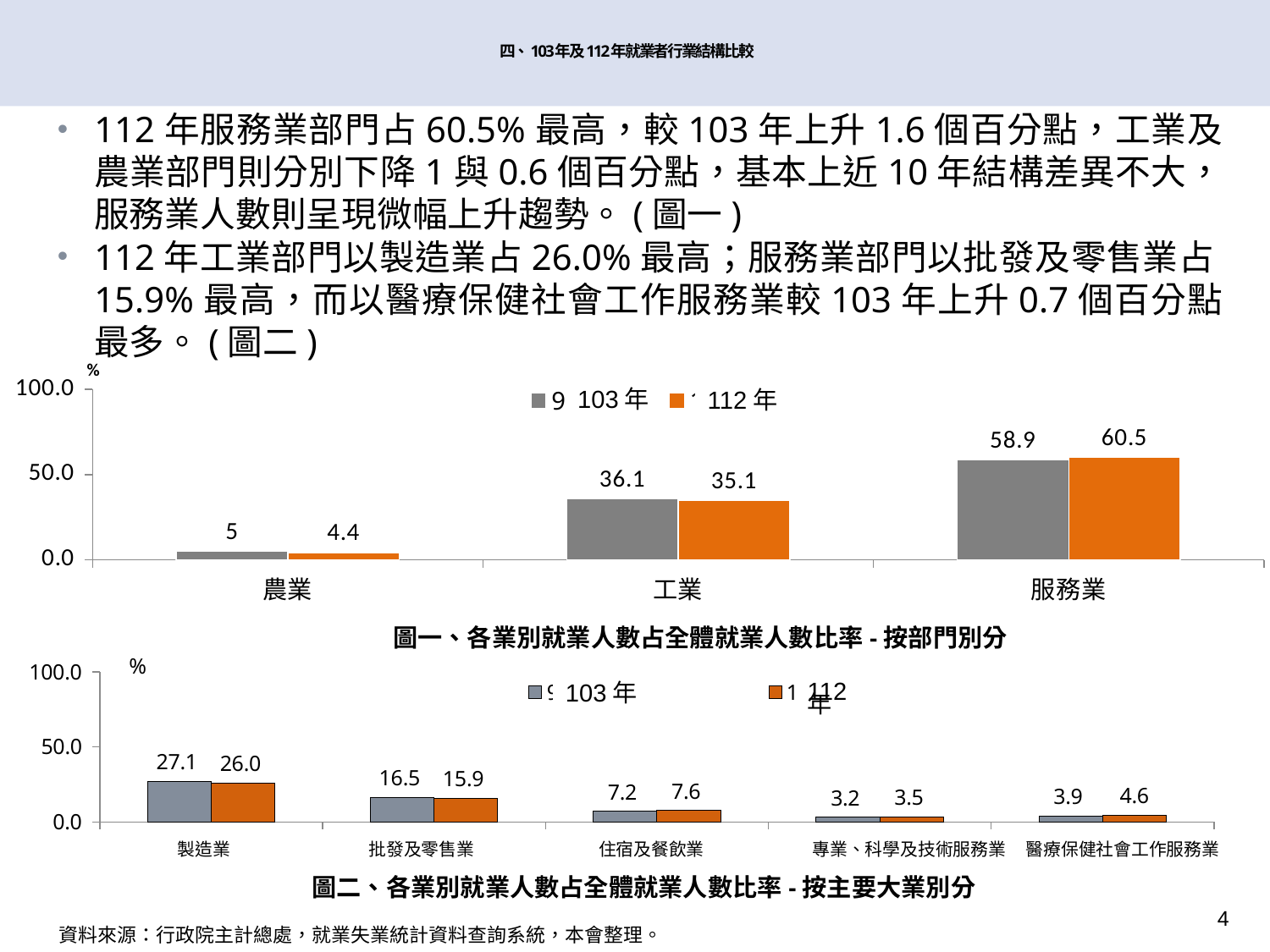
In the bottom chart (圖二), how many series does the legend list? 2 In the bottom chart (圖二), what is the difference between the 112年 and 103年 values for 醫療保健社會工作服務業? 0.7 In the top chart (圖一), which category has the highest value in 112年? 服務業 In the top chart (圖一), how many categories are shown on the x axis? 3 In the bottom chart (圖二), is the value for 製造業 in 103年 greater or less than 50.0? less In the bottom chart (圖二), what is the value for 批發及零售業 in 112年? 15.9 In the top chart (圖一), what kind of chart is it? bar chart In the top chart (圖一), what is the difference between the 103年 and 112年 values for 工業? 1 In the top chart (圖一), what is the value for 服務業 in 112年? 60.5 In the bottom chart (圖二), which category has the lowest value in 103年? 專業、科學及技術服務業 In the top chart (圖一), what is the value for 農業 in 103年? 5 In the bottom chart (圖二), which is larger for 住宿及餐飲業: the 103年 value or the 112年 value? 112年